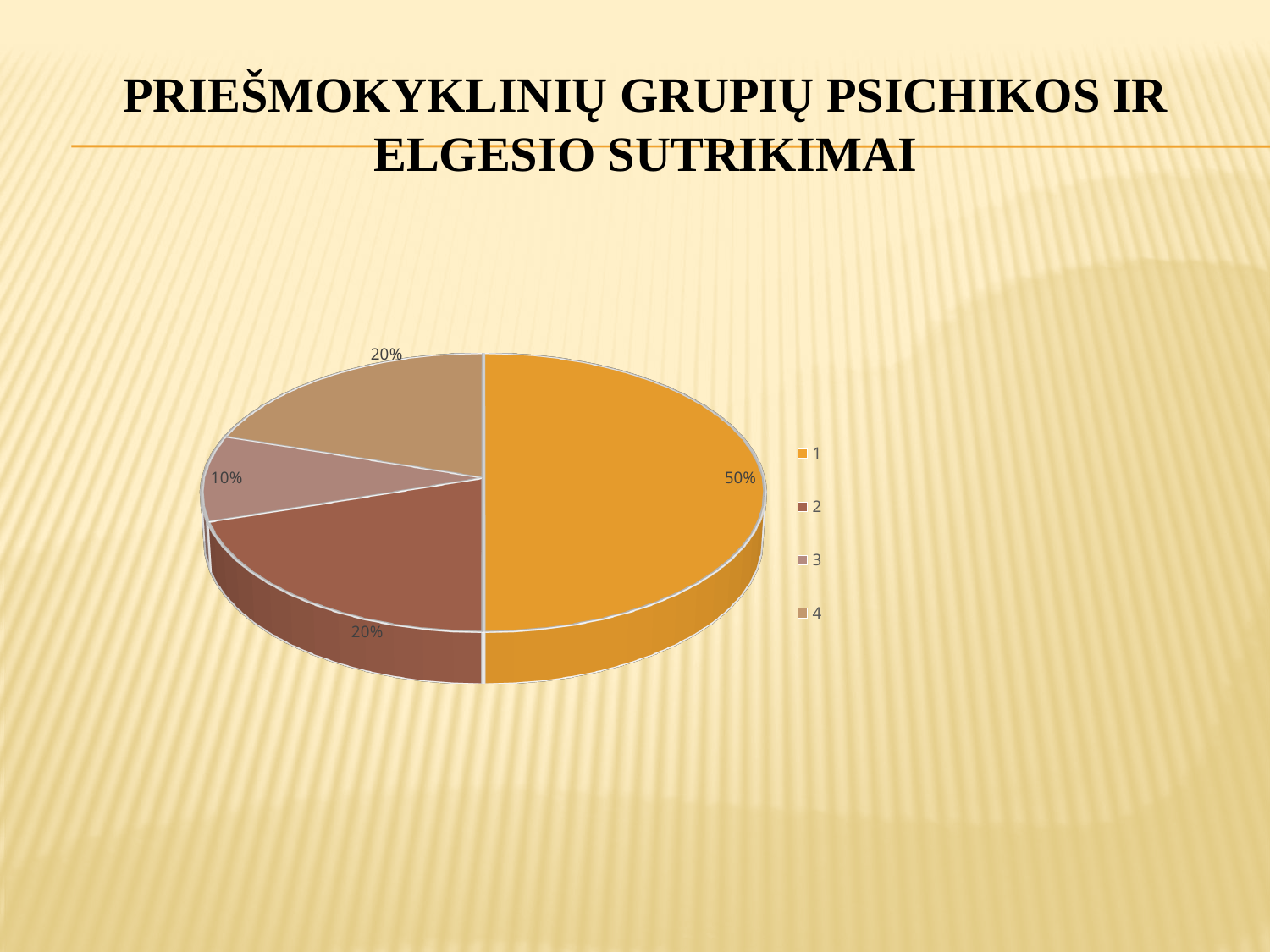
What share of the pie does category 1 have? 50% What is the title of the slide containing the pie chart? PRIEŠMOKYKLINIŲ GRUPIŲ PSICHIKOS IR ELGESIO SUTRIKIMAI Which is larger, the slice for category 1 or the slice for category 2? 1 What share of the pie does category 3 have? 10% What share of the pie does category 4 have? 20% Which category has the smallest slice of the pie? 3 What kind of chart is shown on the slide? pie chart How many entries does the legend list? 4 How many slices does the pie chart have? 4 What share of the pie does category 2 have? 20% Which category has the largest slice of the pie? 1 What is the difference in percentage points between the slice for category 1 and the slice for category 3? 40